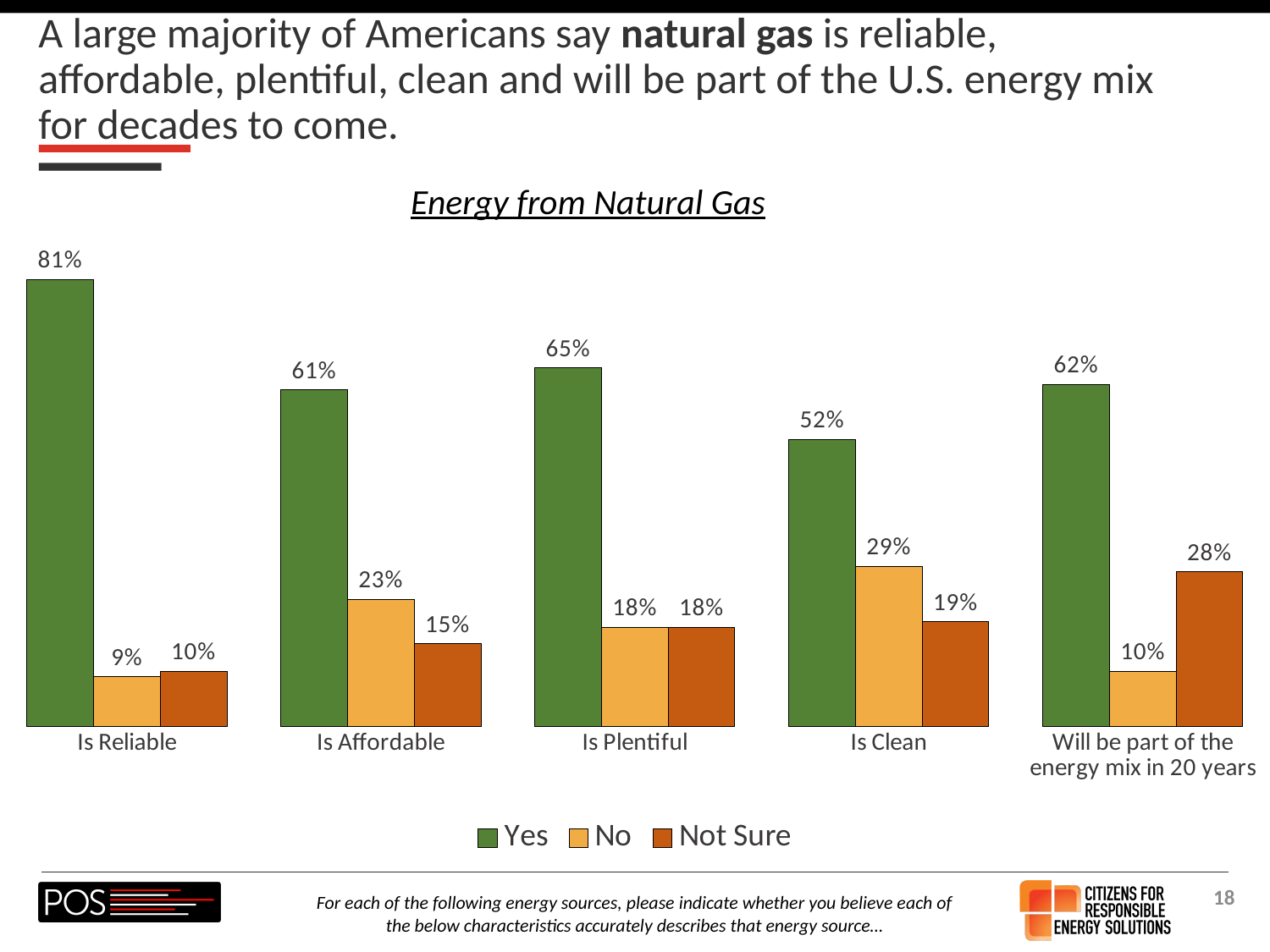
Which colour represents the Yes series? Green What kind of chart is shown? Bar chart What percentage said Not Sure for 'Will be part of the energy mix in 20 years'? 28% Which is larger, the No value for 'Is Affordable' or the No value for 'Is Plentiful'? Is Affordable How many series does the legend list? 3 What percentage said No that natural gas is clean? 29% What percentage said Yes that natural gas is reliable? 81% How many categories are shown on the x axis? 5 Which category has the lowest Yes value? Is Clean What is the difference between the Yes values for 'Is Reliable' and 'Is Clean'? 29% What is the title of the chart? Energy from Natural Gas Which category has the highest Yes value? Is Reliable